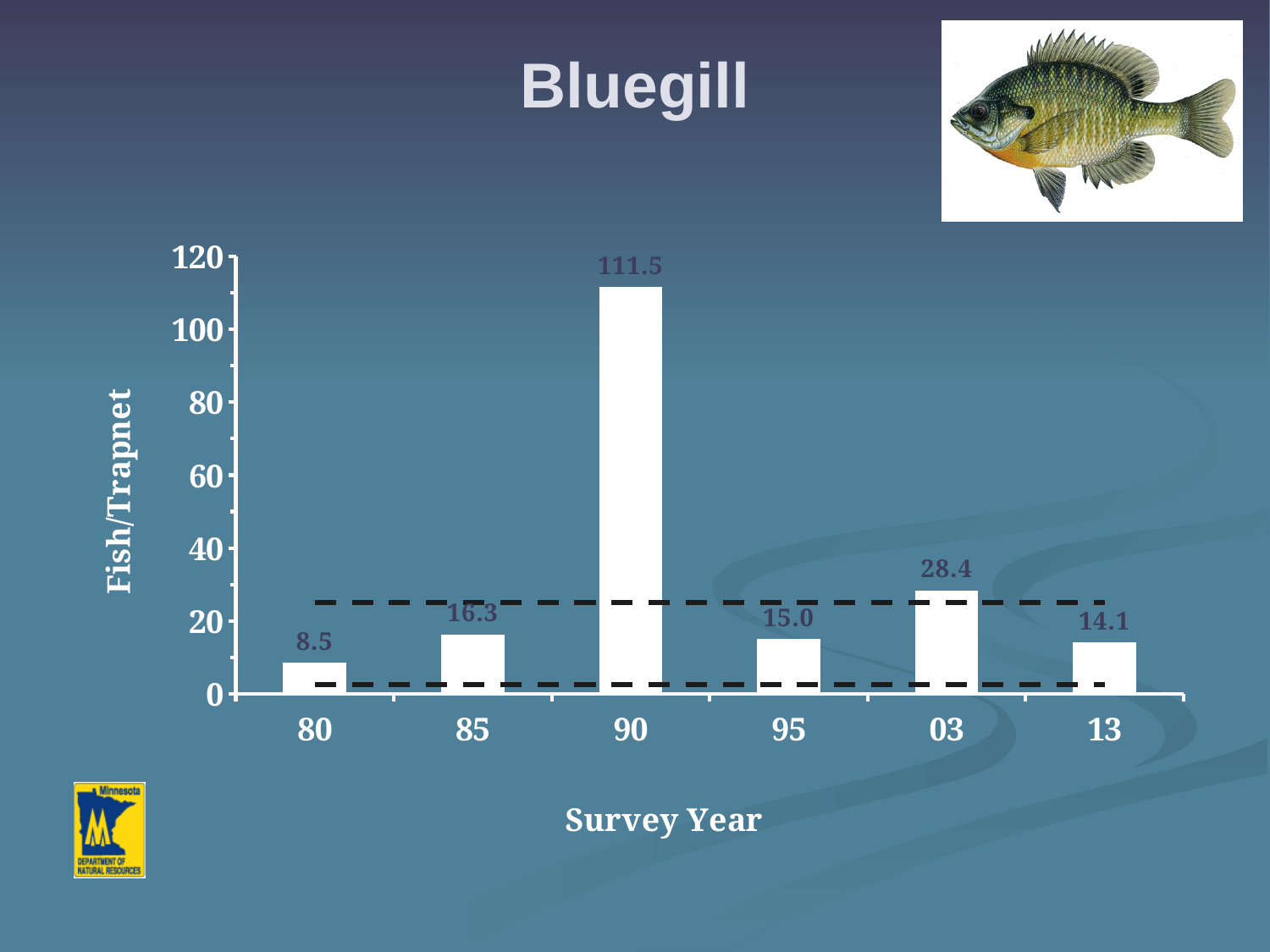
Is the value for survey year 03 greater or less than 20? greater Which survey year has a larger Fish/Trapnet value, 85 or 95? 85 What is the Fish/Trapnet value for survey year 03? 28.4 What kind of chart is shown on the slide? bar chart What is the Fish/Trapnet value for survey year 80? 8.5 How many survey years are shown on the x axis? 6 Which survey year has the lowest Fish/Trapnet value? 80 What is the label of the y axis? Fish/Trapnet What is the Fish/Trapnet value for survey year 13? 14.1 Which survey year has the highest Fish/Trapnet value? 90 What is the Fish/Trapnet value for survey year 90? 111.5 What is the difference between the Fish/Trapnet values for survey years 90 and 03? 83.1